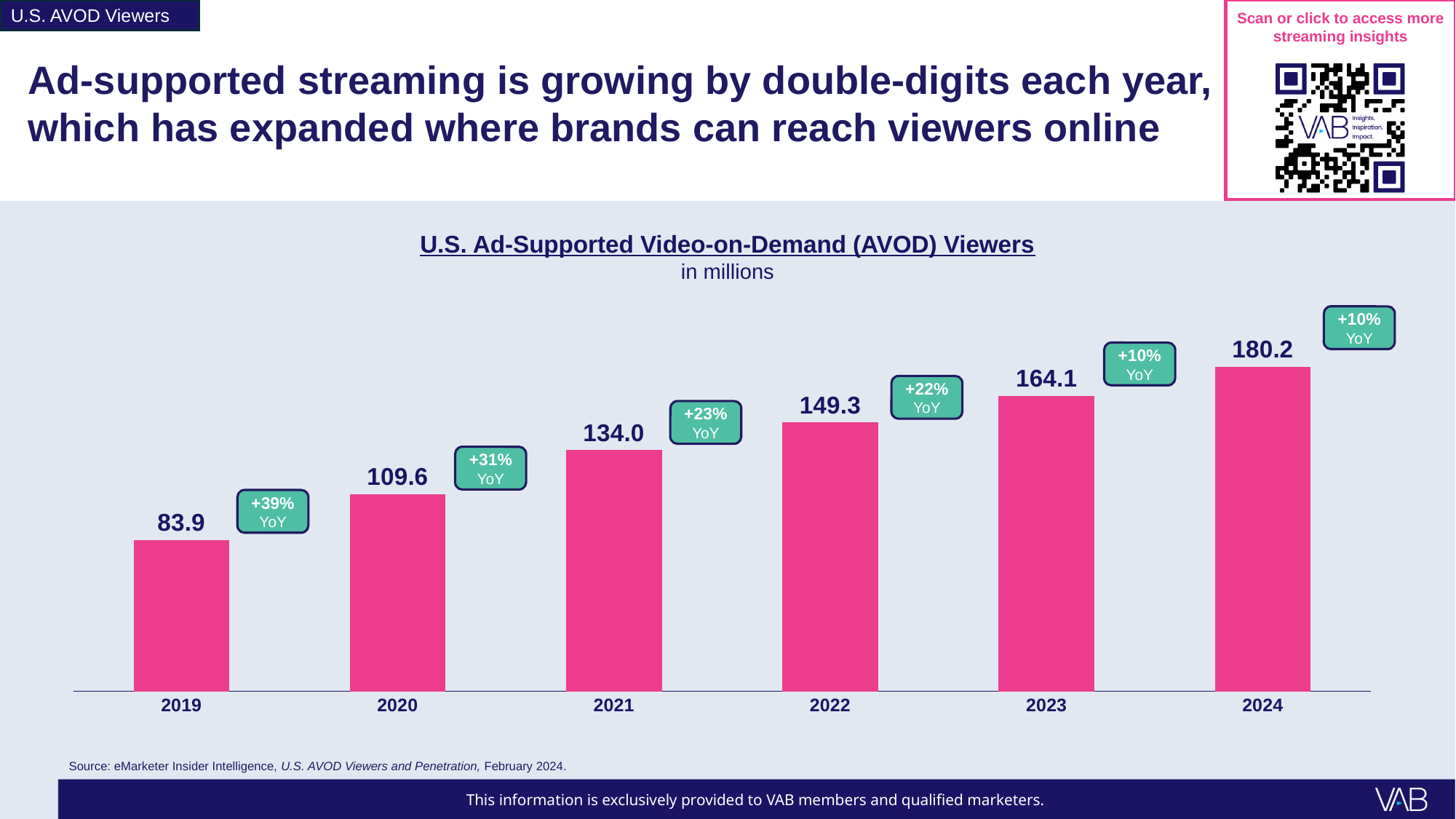
What kind of chart is this? bar chart What is the difference between the values for 2021 and 2020? 24.4 What is the value for 2024? 180.2 What is the value for 2022? 149.3 What is the value for 2019? 83.9 Which is larger, the value for 2021 or the value for 2022? 2022 How many years are shown on the x axis? 6 What is the year-over-year growth shown for 2020? +31% Do the values rise or fall from 2019 to 2024? rise Which year has the lowest value? 2019 Which year has the highest value? 2024 What is the difference between the values for 2024 and 2023? 16.1